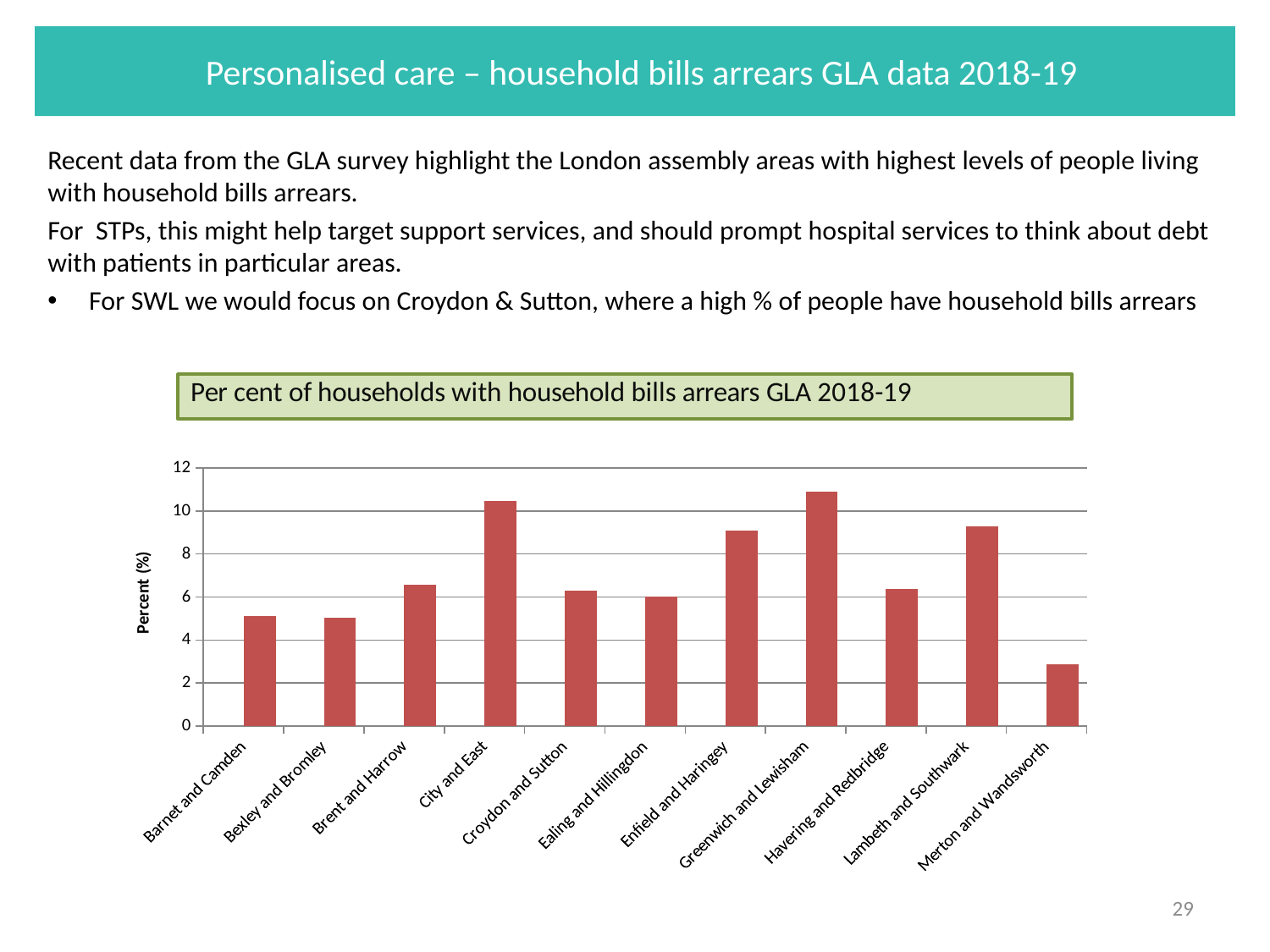
Which is larger, the value for City and East or the value for Enfield and Haringey? City and East Which area has the lowest per cent of households with household bills arrears? Merton and Wandsworth What type of chart is shown on the slide? bar chart Which is larger, the value for Barnet and Camden or the value for Merton and Wandsworth? Barnet and Camden Is the value for Bexley and Bromley greater or less than 6? less Is the value for Croydon and Sutton greater or less than 8? less How many London assembly areas are plotted on the chart? 11 What is the label on the vertical axis of the chart? Percent (%) Is the value for City and East greater or less than 10? greater Which area has the highest per cent of households with household bills arrears? Greenwich and Lewisham